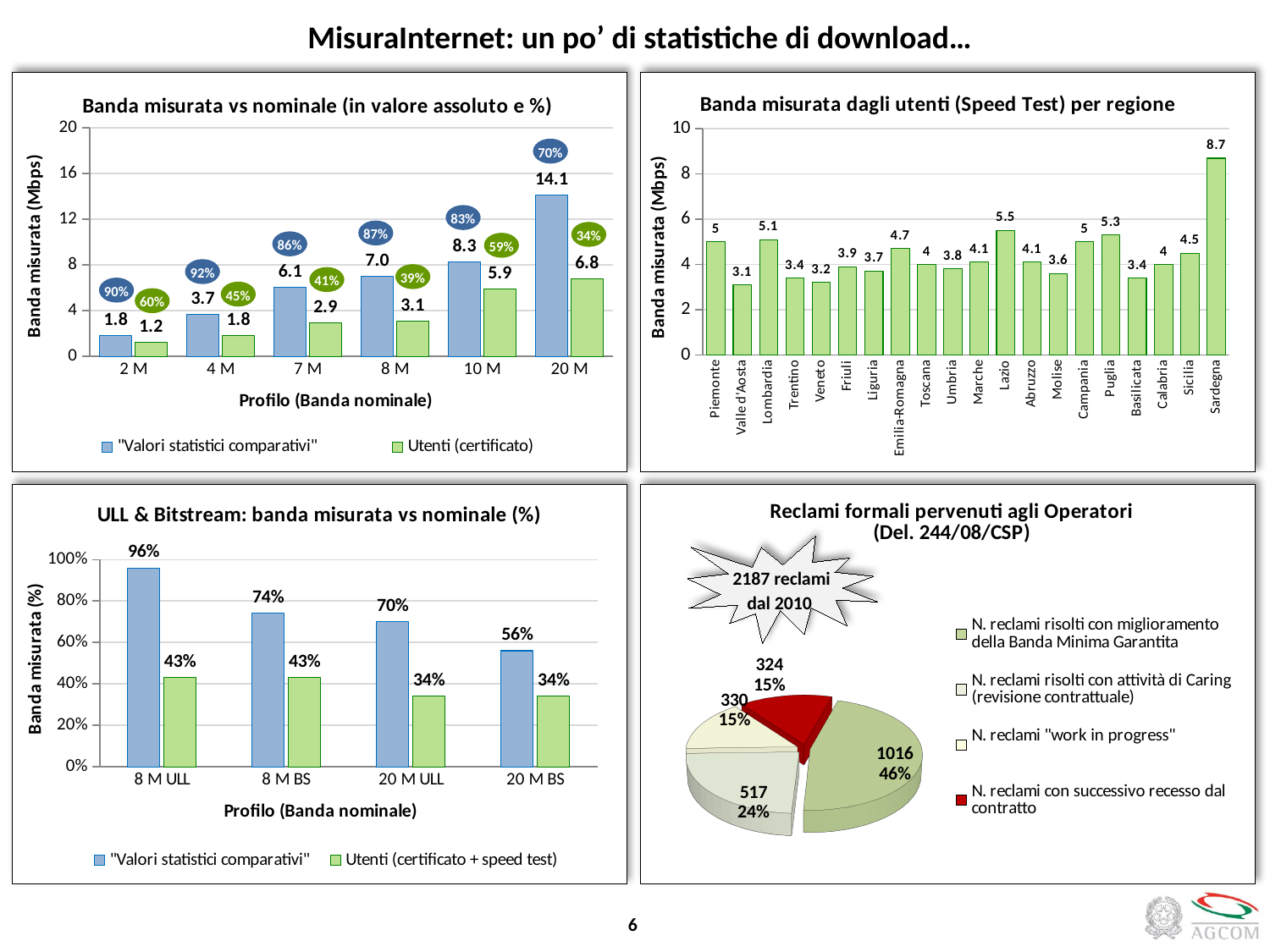
In the chart 'Banda misurata vs nominale (in valore assoluto e %)', what is the difference between the two series for the 8 M profile? 3.9 In the chart 'Banda misurata vs nominale (in valore assoluto e %)', what is the value of 'Utenti (certificato)' for the 10 M profile? 5.9 In the chart 'Banda misurata dagli utenti (Speed Test) per regione', which region has the highest value? Sardegna In the chart 'Banda misurata vs nominale (in valore assoluto e %)', what is the value of 'Valori statistici comparativi' for the 20 M profile? 14.1 In the chart 'Banda misurata dagli utenti (Speed Test) per regione', how many regions are shown? 20 In the chart 'ULL & Bitstream: banda misurata vs nominale (%)', what is the value of 'Valori statistici comparativi' for 8 M ULL? 96% In the chart 'Banda misurata dagli utenti (Speed Test) per regione', which region has the lowest value? Valle d'Aosta In the chart 'ULL & Bitstream: banda misurata vs nominale (%)', which is larger for 20 M BS: 'Valori statistici comparativi' or 'Utenti (certificato + speed test)'? Valori statistici comparativi In the chart 'Banda misurata vs nominale (in valore assoluto e %)', how many profiles are shown on the x axis? 6 In the chart 'Reclami formali pervenuti agli Operatori', what share of the pie does the largest slice represent? 46% What kind of chart is 'Reclami formali pervenuti agli Operatori (Del. 244/08/CSP)'? Pie chart In the chart 'Banda misurata dagli utenti (Speed Test) per regione', what is the value for Lazio? 5.5